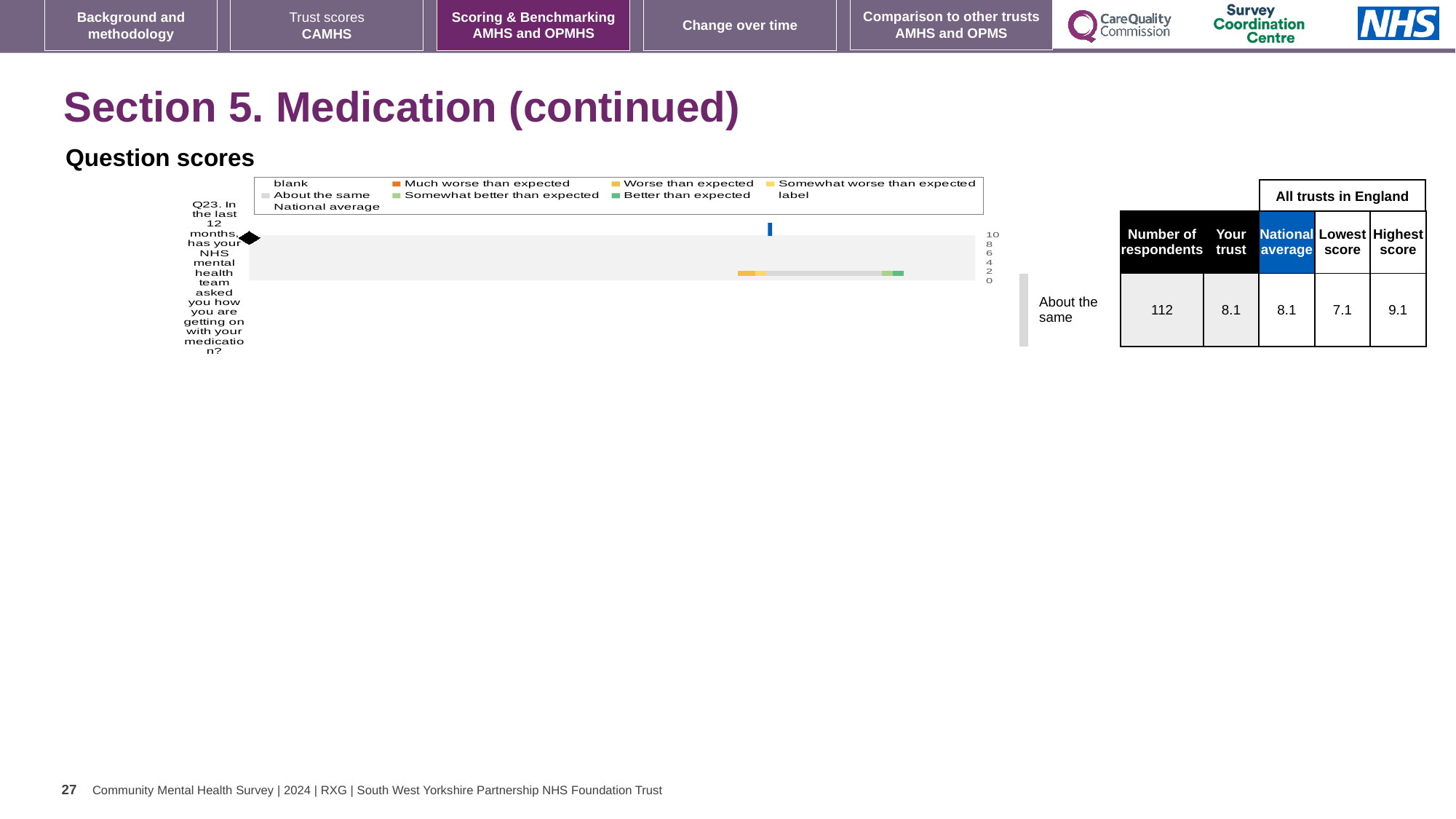
In the table beside the chart, what is the difference between the highest score and the lowest score for Q23? 2.0 In the table beside the chart, what is the national average score for Q23? 8.1 In the table beside the chart, what is the lowest score among all trusts in England for Q23? 7.1 Which question is plotted in the chart? Q23. In the last 12 months, has your NHS mental health team asked you how you are getting on with your medication? In the table beside the chart, which is larger for Q23: the highest score or the 'Your trust' score? Highest score How many survey questions (categories) are plotted in the chart? 1 In the table beside the chart, what is the 'Your trust' score for Q23? 8.1 In the table beside the chart, what is the number of respondents for Q23? 112 What colour represents 'Much worse than expected' in the chart legend? orange What benchmark category is shown for Q23 next to the chart? About the same What kind of chart is shown under 'Question scores'? bar chart In the table beside the chart, what is the highest score among all trusts in England for Q23? 9.1